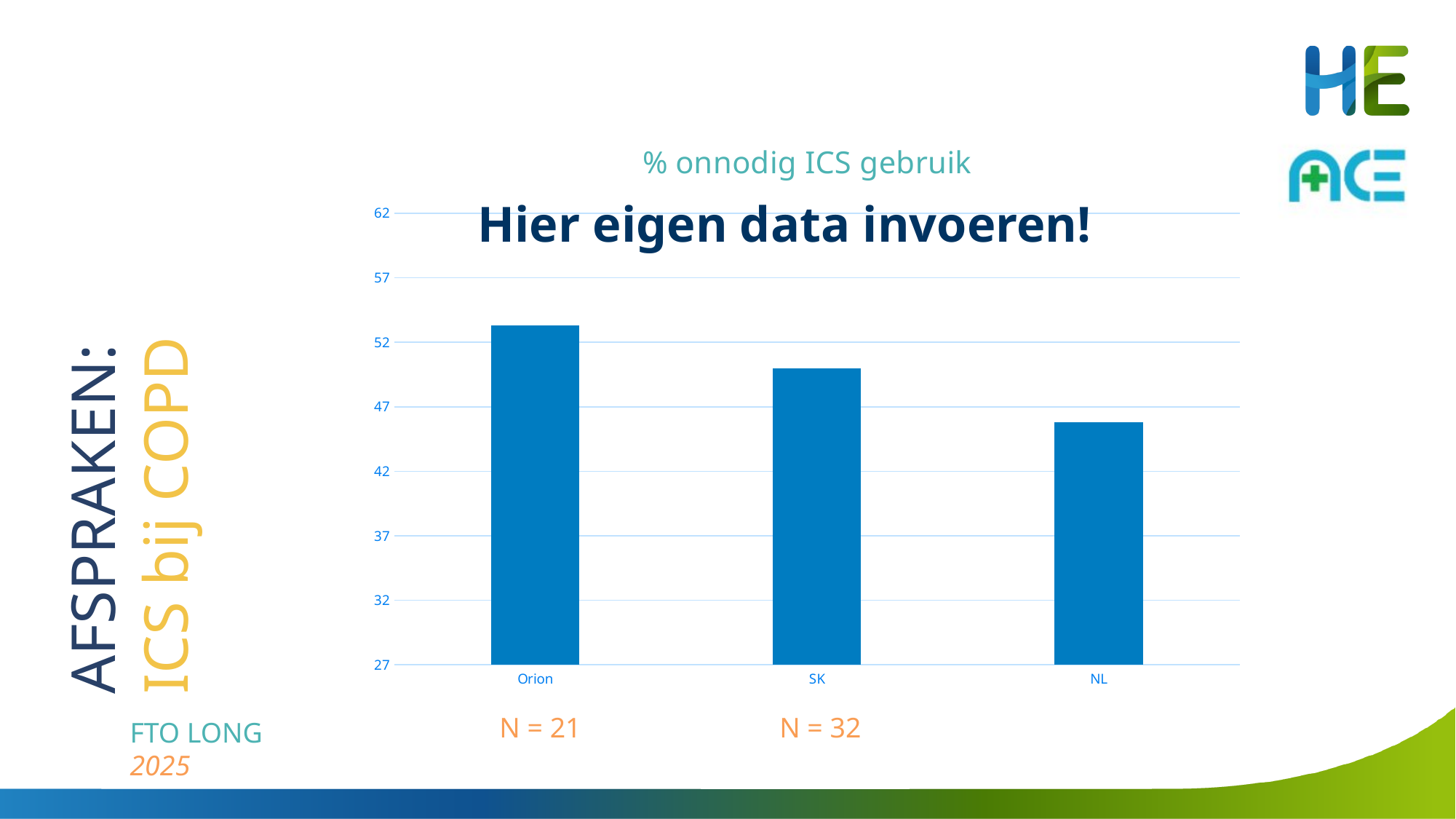
Which category has the lowest value in the chart? NL Which has a larger value, Orion or SK? Orion Which category has the highest value in the chart? Orion Is the value for SK greater or less than 52? less What is the label of the first category on the x axis? Orion Which has a larger value, SK or NL? SK Is the value for NL greater or less than 42? greater What kind of chart is shown on the slide? bar chart Do the values rise or fall from left to right across the categories? fall Is the value for Orion greater or less than 47? greater How many categories are shown on the x axis of the chart? 3 What is the title of the chart? % onnodig ICS gebruik